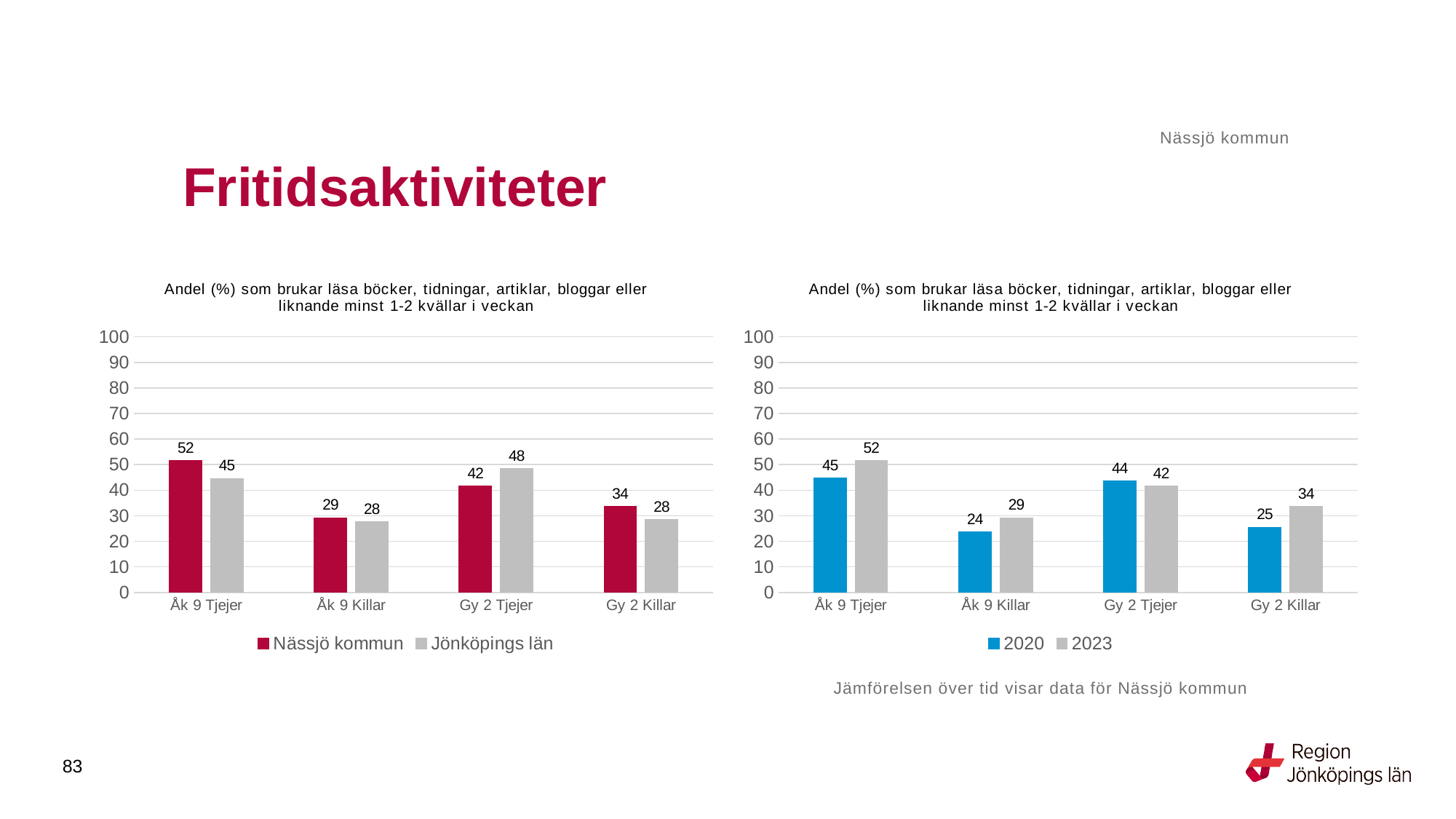
In the left chart, which category has the highest value for Nässjö kommun? Åk 9 Tjejer How many series does the legend of the left chart list? 2 What kind of chart is the right chart? Bar chart In the right chart, which category has the lowest value for 2020? Åk 9 Killar In the left chart, which is larger for Gy 2 Tjejer: Nässjö kommun or Jönköpings län? Jönköpings län In the right chart, what is the value for 2023 for Gy 2 Killar? 34 In the left chart, what is the difference between Nässjö kommun and Jönköpings län for Åk 9 Tjejer? 7 In the left chart, what is the value for Nässjö kommun for Åk 9 Tjejer? 52 In the right chart, what is the difference between 2023 and 2020 for Gy 2 Killar? 9 In the left chart, what is the value for Jönköpings län for Gy 2 Tjejer? 48 In the right chart, what is the value for 2020 for Åk 9 Killar? 24 How many categories are shown on the x axis of the right chart? 4